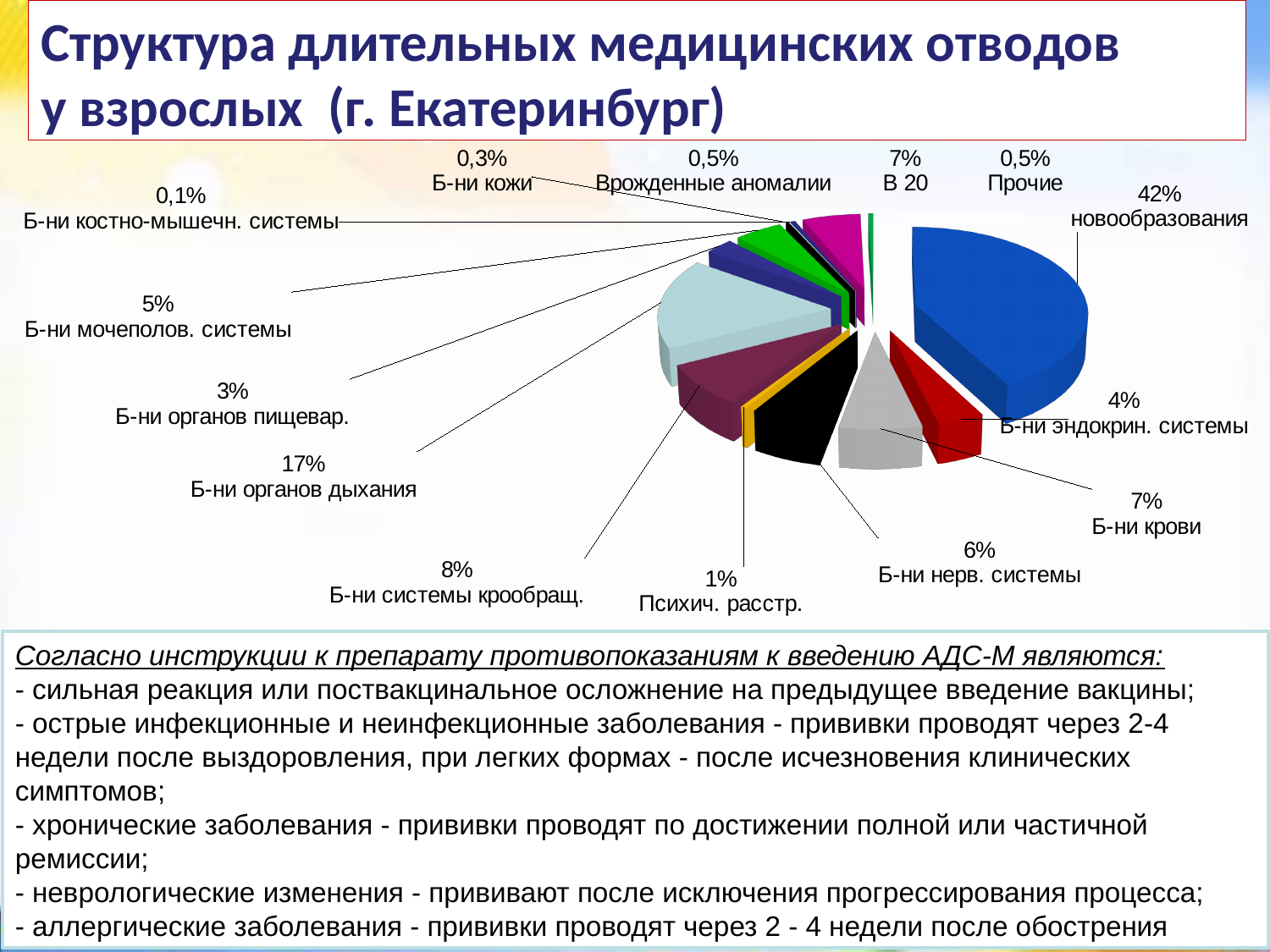
How many categories are shown in the pie chart? 14 What is the share for Б-ни системы кроообращ.? 8% What is the share for Б-ни костно-мышечн. системы? 0,1% What is the share for Б-ни кожи? 0,3% Which category has the largest share of the pie? новообразования What is the title of the slide containing the chart? Структура длительных медицинских отводов у взрослых (г. Екатеринбург) What is the share for Б-ни органов дыхания? 17% What is the share for новообразования? 42% Which is larger, the share for Б-ни нерв. системы or the share for Б-ни мочеполов. системы? Б-ни нерв. системы Which category has the smallest share of the pie? Б-ни костно-мышечн. системы What kind of chart is shown on the slide? pie chart What is the difference in percentage points between новообразования and Б-ни органов дыхания? 25